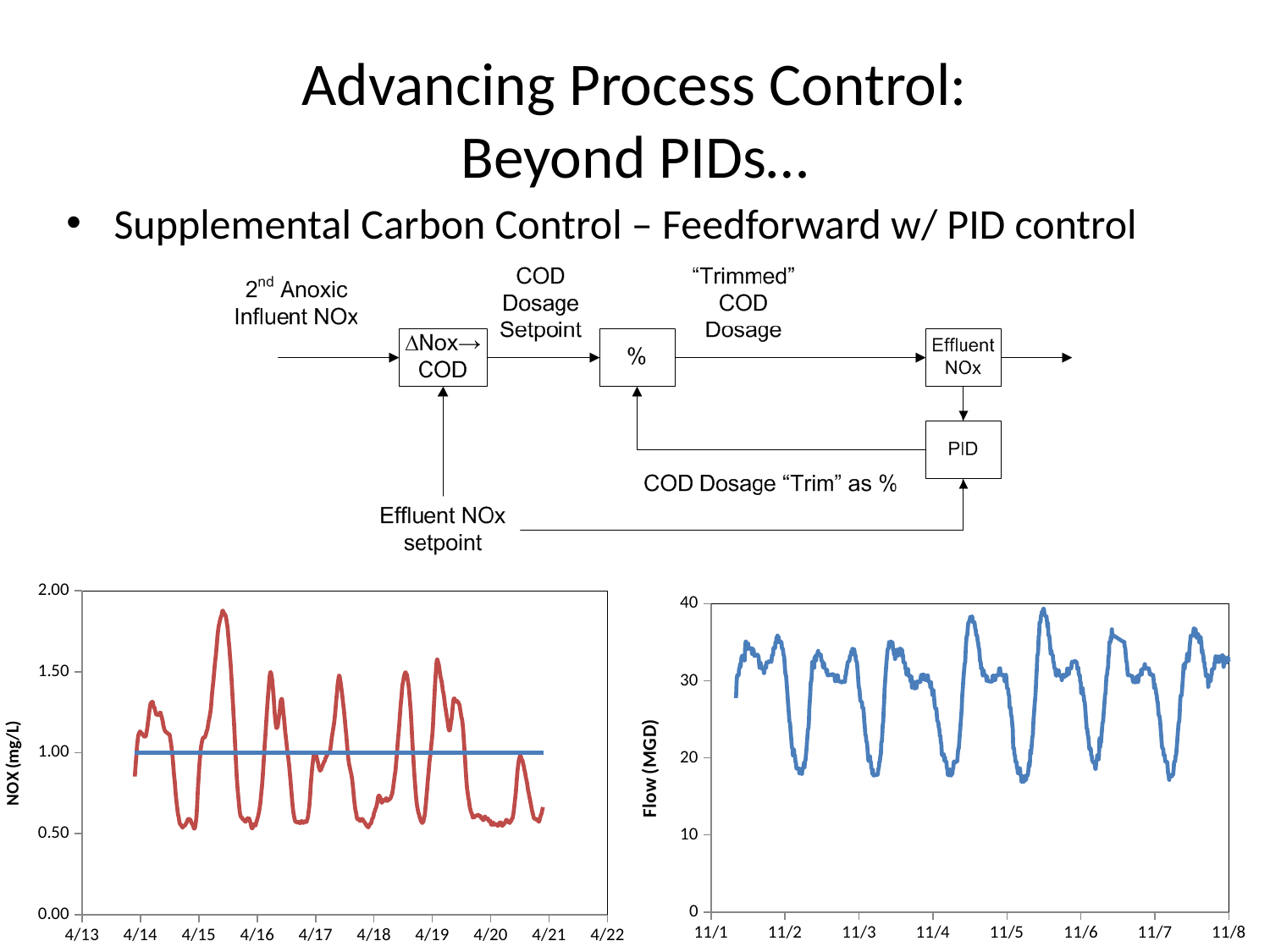
On the right chart, what is the y-axis title? Flow (MGD) On the left chart, is the highest peak of the red line (around 4/15) greater or less than 1.50? greater On the left chart, at what value does the flat blue line sit? 1.00 On the left chart, what is the y-axis title? NOX (mg/L) On the right chart, is the highest peak of the flow line (around 11/5) greater or less than 30? greater On the left chart, which is higher: the red line's peak near 4/15 or its peak near 4/19? the peak near 4/15 What type of chart is the right chart with the Flow (MGD) axis? line chart How many date labels are shown on the x-axis of the right chart? 8 On the left chart, is the lowest point of the red line (around 4/16) greater or less than 1.00? less How many lines are plotted on the left chart? 2 What type of chart is the left chart with the NOX (mg/L) axis? line chart